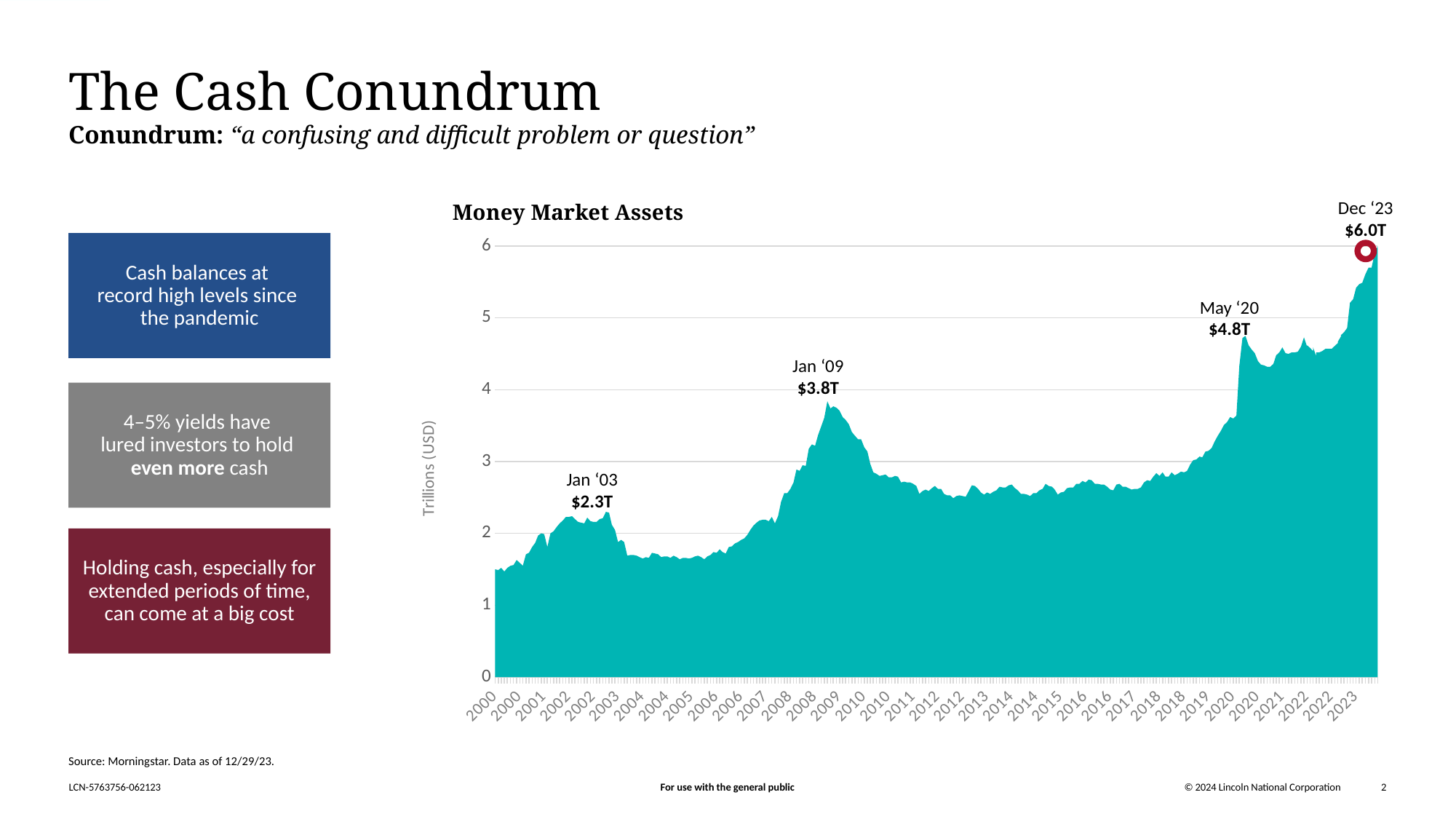
What is the difference between the Dec '23 value and the Jan '03 value? $3.7T What value is labeled for Dec '23 on the chart? $6.0T Which labeled point on the chart has the lowest value? Jan '03 What kind of chart is used to show Money Market Assets? Area chart Which is larger, the value labeled for Jan '09 or the value labeled for May '20? May '20 What value is labeled for May '20 on the chart? $4.8T What value is labeled for Jan '09 on the chart? $3.8T Which labeled point on the chart has the highest value? Dec '23 What value is labeled for Jan '03 on the chart? $2.3T What is the label on the vertical axis of the chart? Trillions (USD) What is the title of the chart? Money Market Assets Is the value at the start of 2000 greater or less than 2 trillion? less